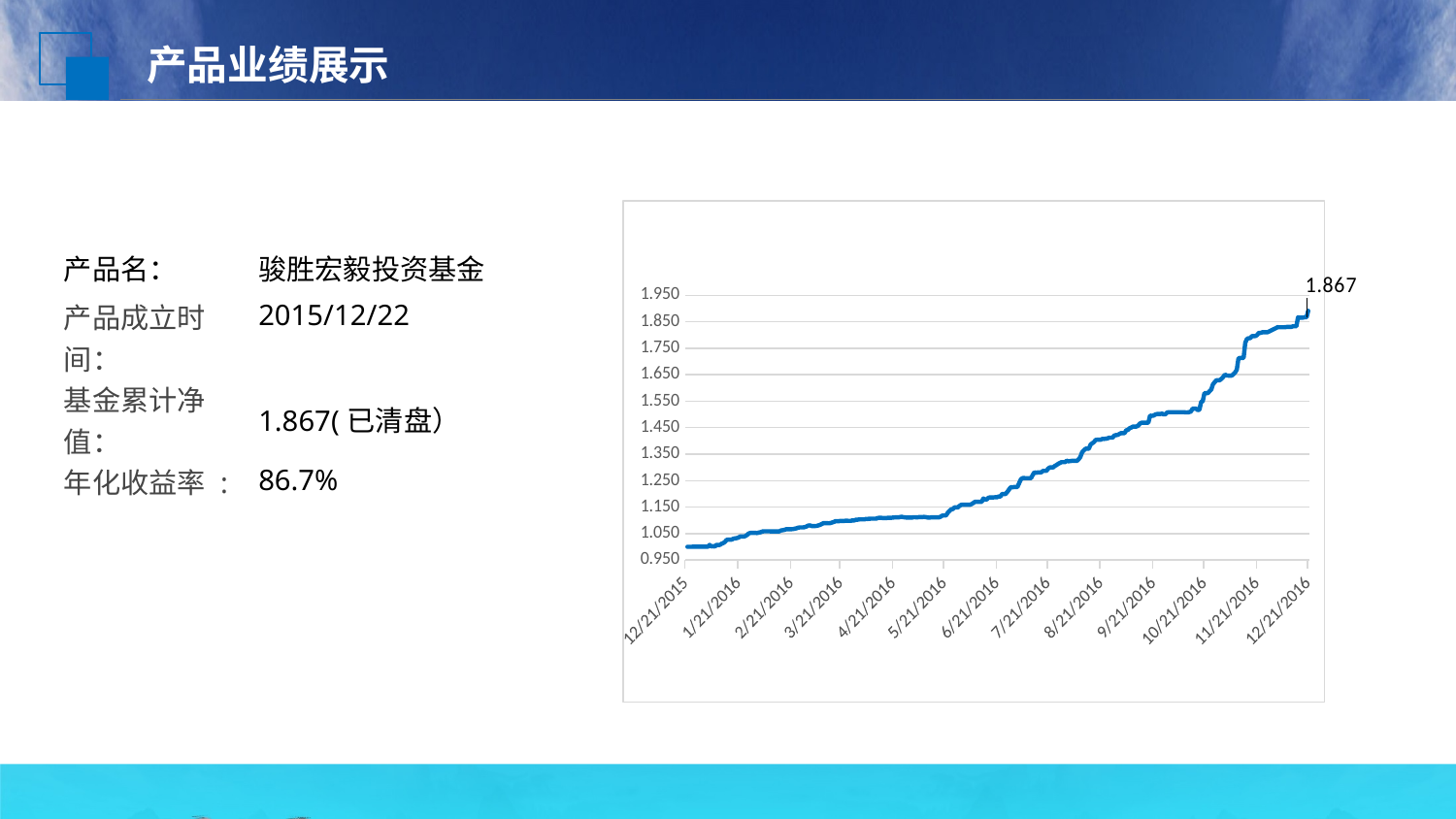
Is the value at 12/21/2015 greater or less than 1.050? less At which date on the x axis is the line at its lowest value? 12/21/2015 Is the value at 9/21/2016 greater or less than 1.350? greater How many date labels are shown on the x axis? 13 Is the value at 5/21/2016 greater or less than 1.150? less Which is larger, the value at 10/21/2016 or the value at 4/21/2016? 10/21/2016 What kind of chart is shown on the slide? line chart Does the line generally rise or fall from 12/21/2015 to 12/21/2016? rise At which date on the x axis does the line reach its highest value? 12/21/2016 What is the value shown by the data label at the end of the line (12/21/2016)? 1.867 What is the highest tick value shown on the y axis? 1.950